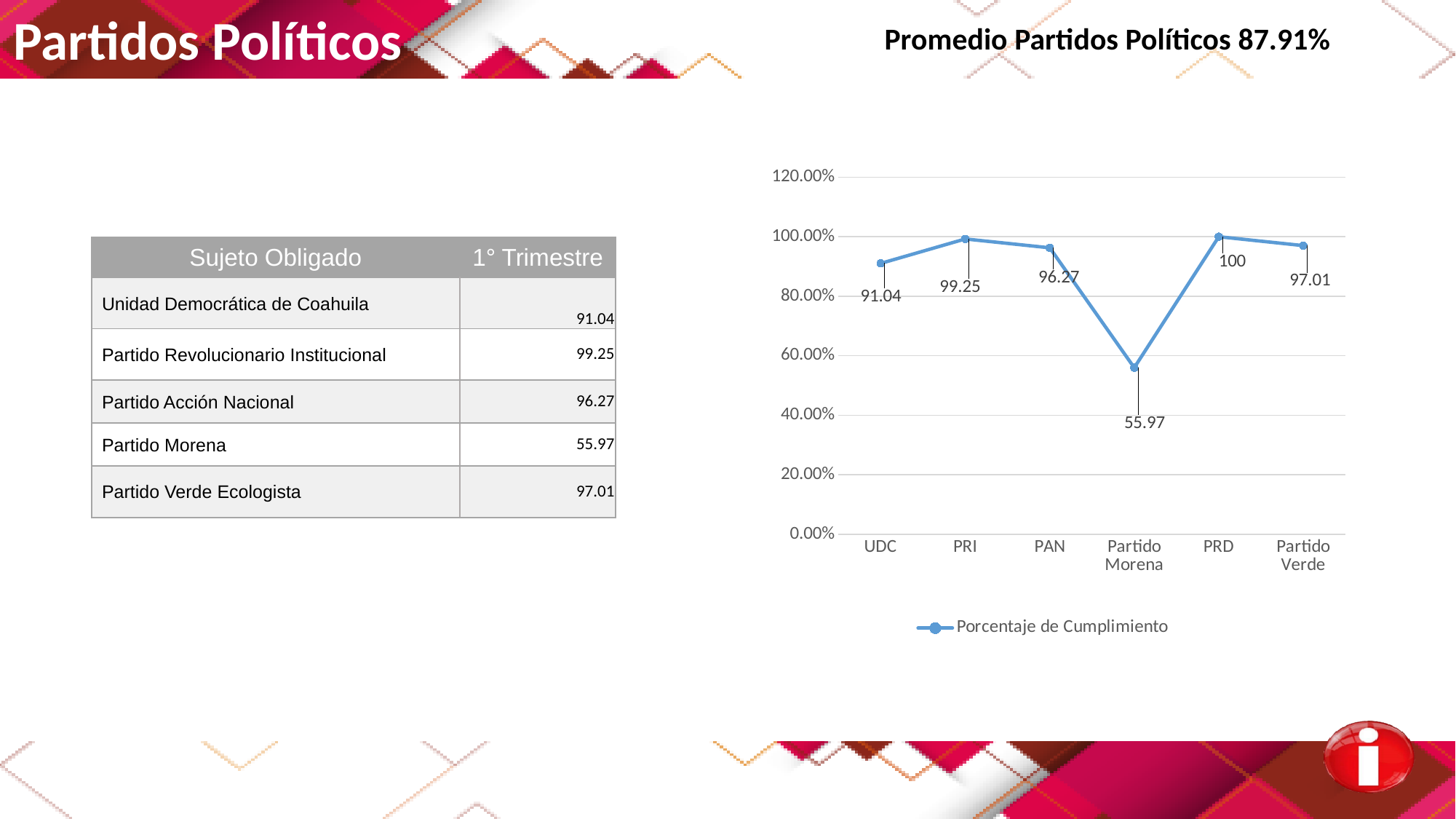
How many categories are plotted on the x axis of the chart? 6 What is the value for PRD in the chart? 100 What is the value for UDC in the chart? 91.04 What is the value for Partido Morena in the chart? 55.97 What is the difference between the values for PRD and Partido Morena? 44.03 What series name does the chart legend show? Porcentaje de Cumplimiento Is the value for Partido Morena greater or less than 60.00%? less What kind of chart is shown on the slide? line chart What is the value for PRI in the chart? 99.25 Which category has the highest value in the chart? PRD Which category has the lowest value in the chart? Partido Morena Which is larger, the value for PAN or the value for Partido Verde? Partido Verde